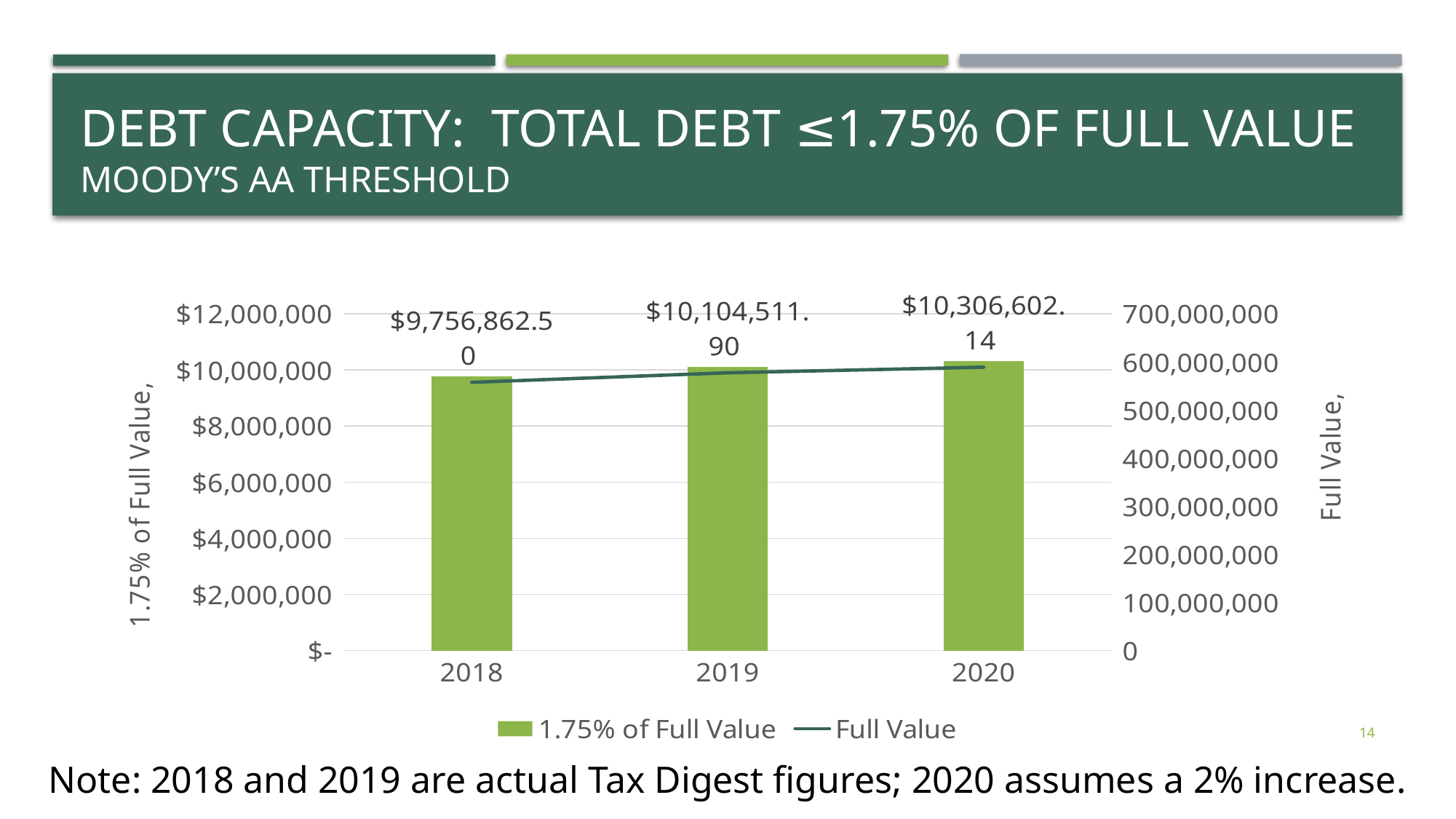
Which year has the highest 1.75% of Full Value bar? 2020 Is the Full Value line for 2018 greater or less than 500,000,000 on the right axis? greater What is the difference between the 1.75% of Full Value bars for 2020 and 2019? $202,090.24 What is the difference between the 1.75% of Full Value bars for 2019 and 2018? $347,649.40 What is the value of the 1.75% of Full Value bar for 2018? $9,756,862.50 How many years are shown on the x axis? 3 How many series does the legend list? 2 What is the value of the 1.75% of Full Value bar for 2019? $10,104,511.90 Which year has the lowest 1.75% of Full Value bar? 2018 Do the 1.75% of Full Value bars rise or fall from 2018 to 2020? rise Is the 1.75% of Full Value bar for 2018 greater or less than $10,000,000? less What is the value of the 1.75% of Full Value bar for 2020? $10,306,602.14